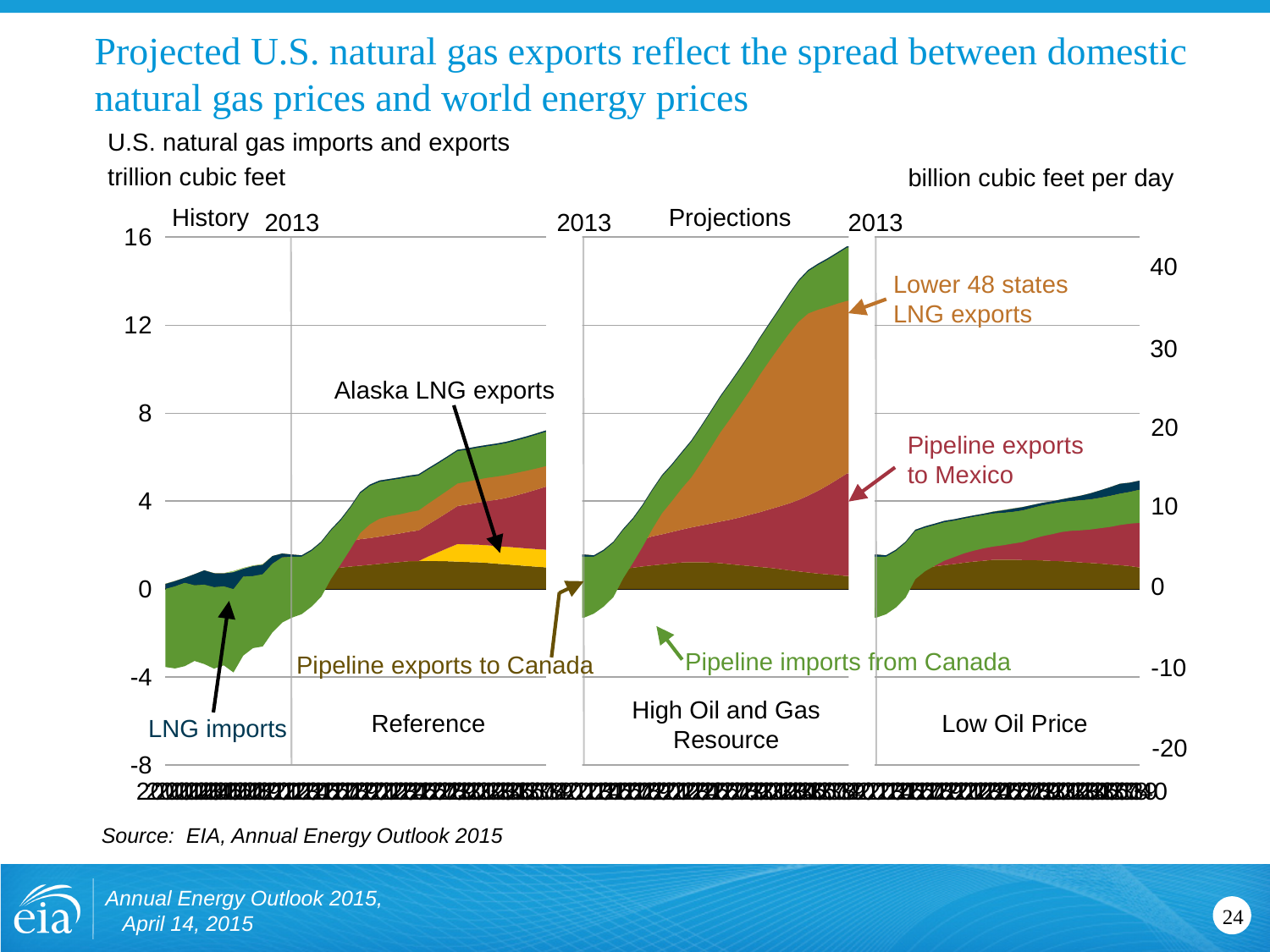
Which series is shown in yellow on the chart? Alaska LNG exports How many scenario panels does the chart show for the projection period? 3 Which scenario panel has the lowest peak total natural gas exports? Low Oil Price In the High Oil and Gas Resource panel, is the peak total of the stacked exports greater or less than 12 trillion cubic feet? greater In the History period, is the lowest point of the stacked imports greater or less than -2 trillion cubic feet? less Is the peak total in the High Oil and Gas Resource panel larger or smaller than the peak total in the Reference panel? larger In the Low Oil Price panel, is the total of the stacked exports at the end of the projection greater or less than 8 trillion cubic feet? less What kind of chart is shown on the slide? area chart Do total natural gas exports rise or fall over the projection period in the High Oil and Gas Resource panel? rise Which scenario panel reaches the highest total natural gas exports? High Oil and Gas Resource What unit is shown on the right-hand axis of the chart? billion cubic feet per day